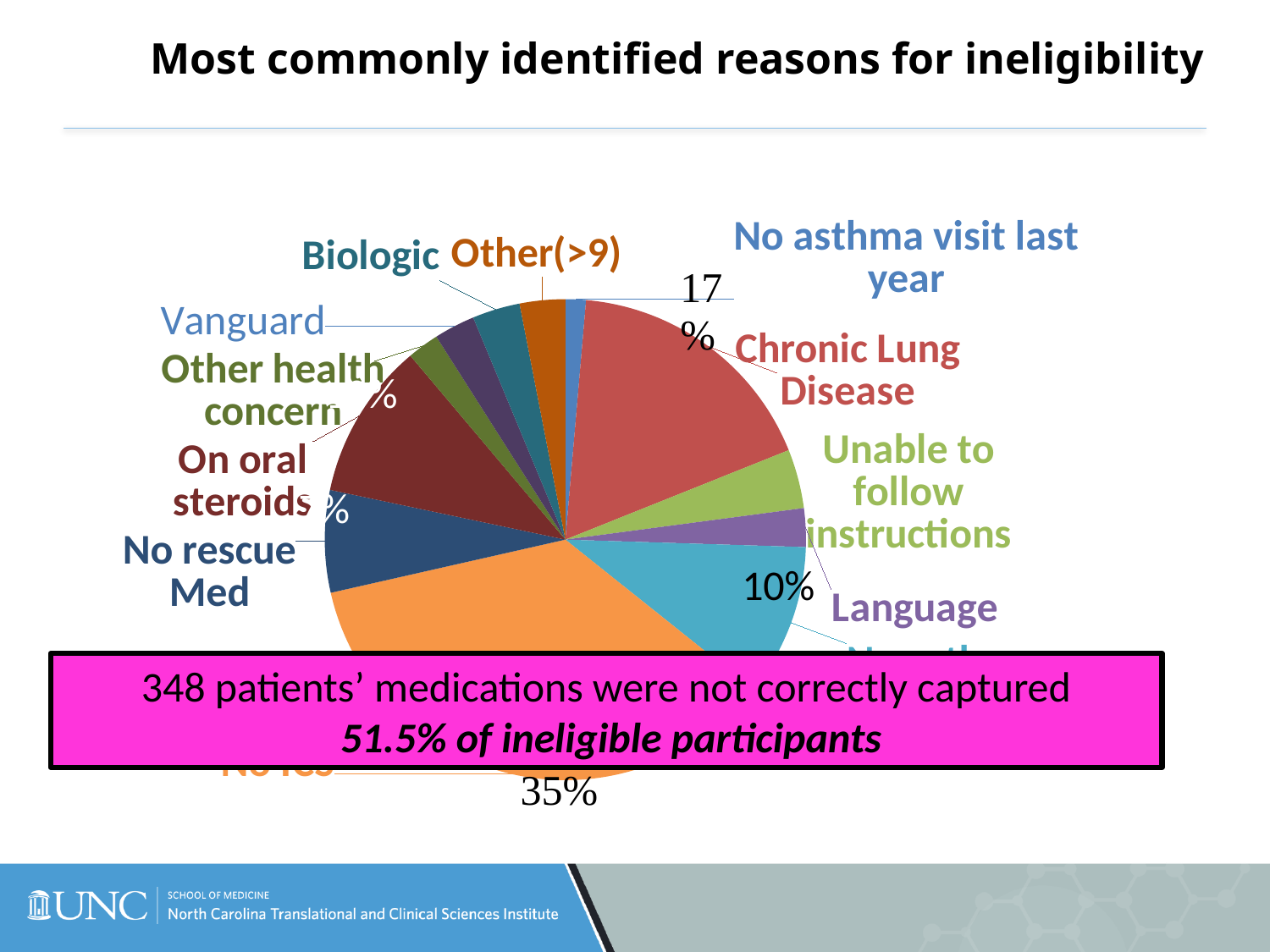
What is the difference between the largest slice (35%) and the Chronic Lung Disease slice (17%)? 18% Which slice is larger: Chronic Lung Disease or Unable to follow instructions? Chronic Lung Disease What colour is the Chronic Lung Disease slice? Red Is the Vanguard slice greater or less than 10% of the pie? less Is the Biologic slice greater or less than 10% of the pie? less Which slice is larger: Chronic Lung Disease or Biologic? Chronic Lung Disease What kind of chart is shown on the slide? Pie chart What is the title of the slide containing the pie chart? Most commonly identified reasons for ineligibility According to the highlighted box, how many patients' medications were not correctly captured? 348 Which slice is larger: Unable to follow instructions or Language? Unable to follow instructions What percentage of the pie is labelled for Chronic Lung Disease? 17% What is the percentage printed on the largest slice of the pie? 35%